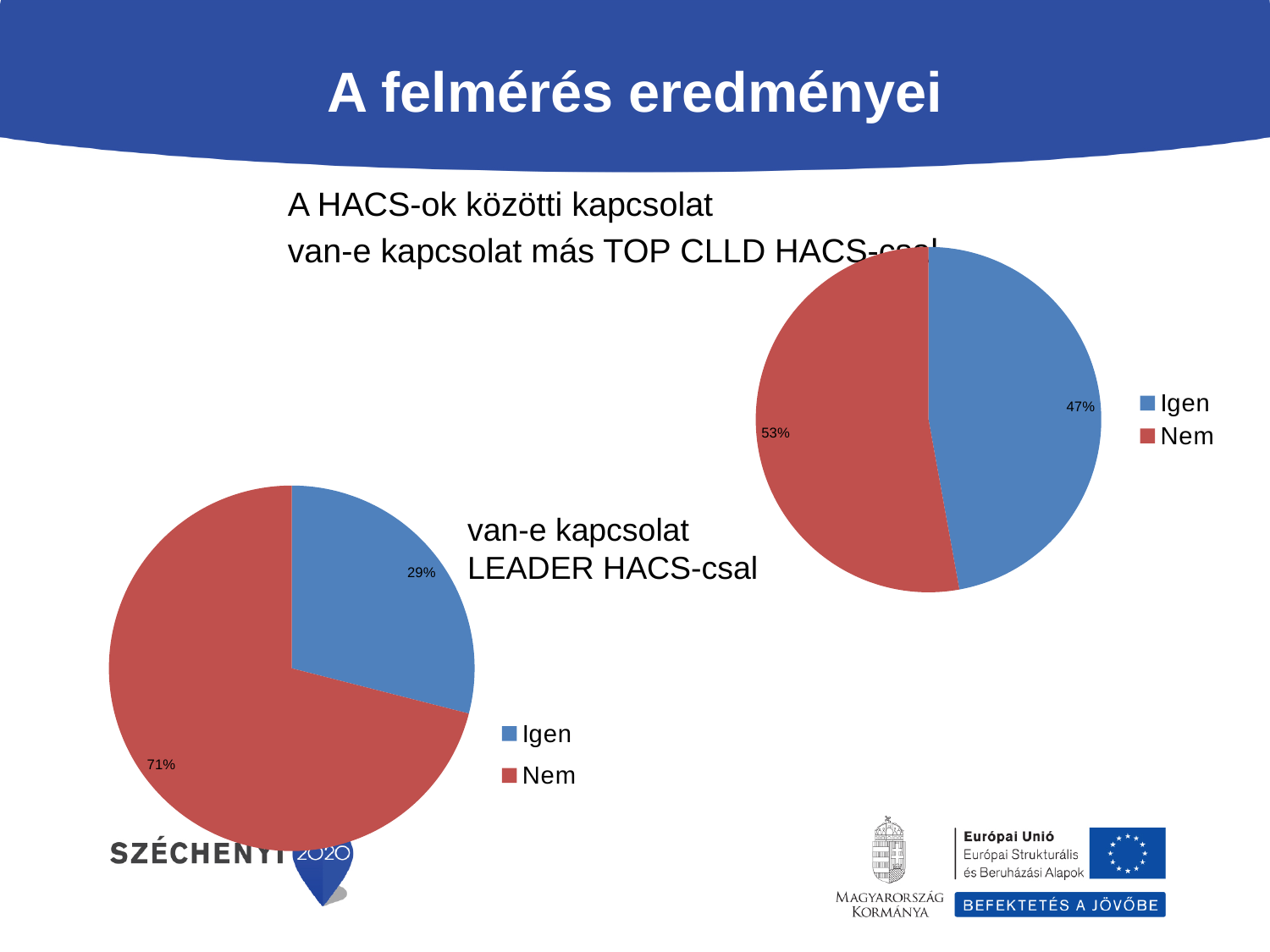
In the lower-left pie chart (LEADER HACS-csal), what colour is the Nem slice? red In the upper-right pie chart (TOP CLLD HACS-csal), what share is labelled for Nem? 53% In the lower-left pie chart (LEADER HACS-csal), which slice is the largest? Nem In the lower-left pie chart (LEADER HACS-csal), what share is labelled for Nem? 71% In the upper-right pie chart (TOP CLLD HACS-csal), what is the difference in percentage points between Nem and Igen? 6 In the upper-right pie chart (TOP CLLD HACS-csal), which slice is larger, Igen or Nem? Nem How many slices does the lower-left pie chart (LEADER HACS-csal) have? 2 In the lower-left pie chart (LEADER HACS-csal), what share is labelled for Igen? 29% What kind of chart is the upper-right chart (van-e kapcsolat más TOP CLLD HACS-csal)? pie chart In the upper-right pie chart (TOP CLLD HACS-csal), what share is labelled for Igen? 47% How many entries does the legend of the upper-right pie chart (TOP CLLD HACS-csal) list? 2 In the lower-left pie chart (LEADER HACS-csal), what is the difference in percentage points between Nem and Igen? 42